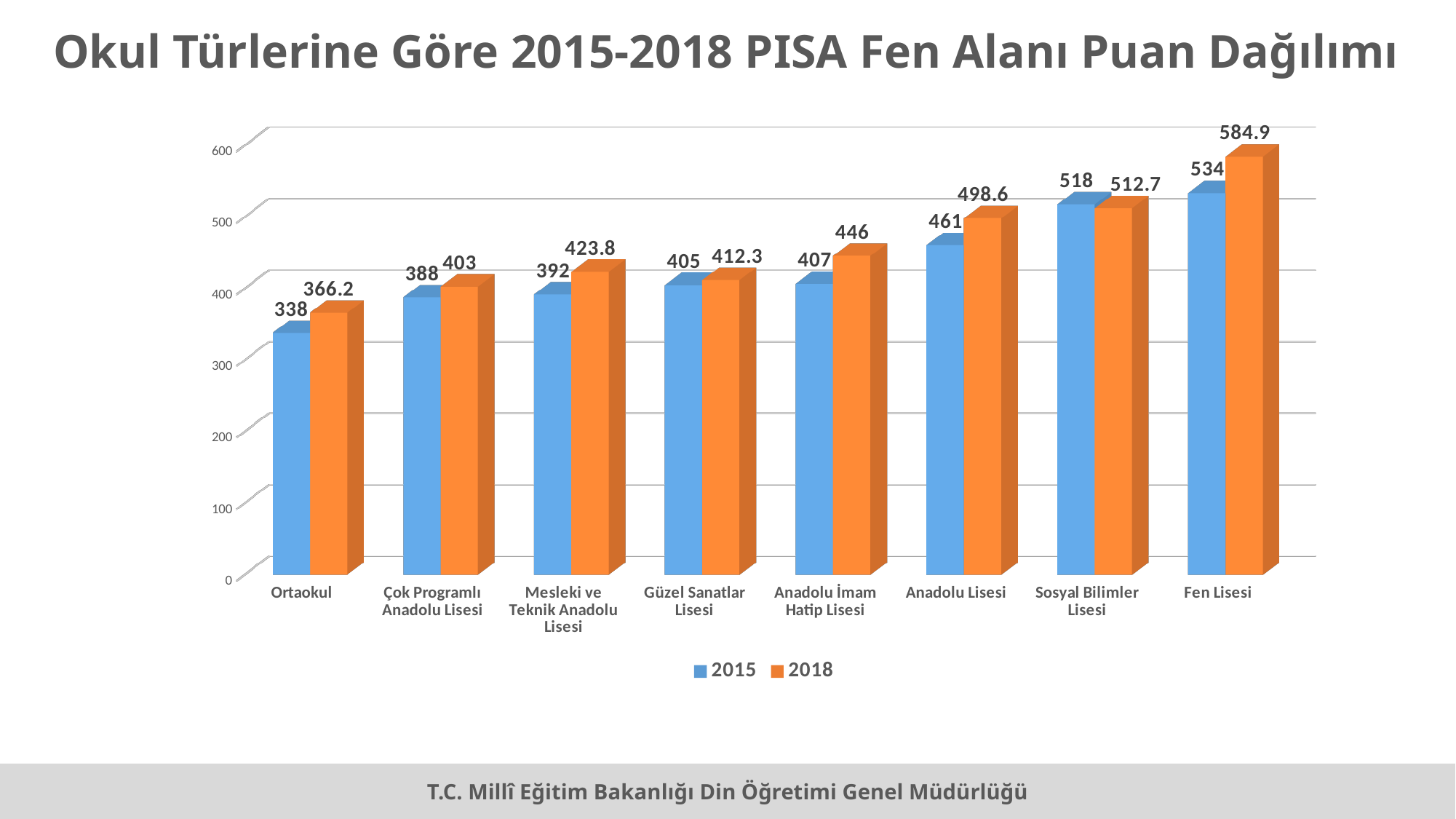
What is the difference between the 2018 and 2015 scores for Anadolu Lisesi? 37.6 How many school types are shown on the x axis? 8 How many series does the legend list? 2 What kind of chart is shown on the slide? Bar chart Which school type has the lowest 2015 score? Ortaokul What is the 2015 PISA science score for Ortaokul? 338 Which school type has the highest 2018 score? Fen Lisesi Which colour represents the 2018 series in the legend? Orange For Sosyal Bilimler Lisesi, which year has the higher score, 2015 or 2018? 2015 Do the 2015 scores rise or fall from left to right across the school types? Rise What is the 2018 PISA science score for Fen Lisesi? 584.9 What is the 2018 score for Anadolu İmam Hatip Lisesi? 446